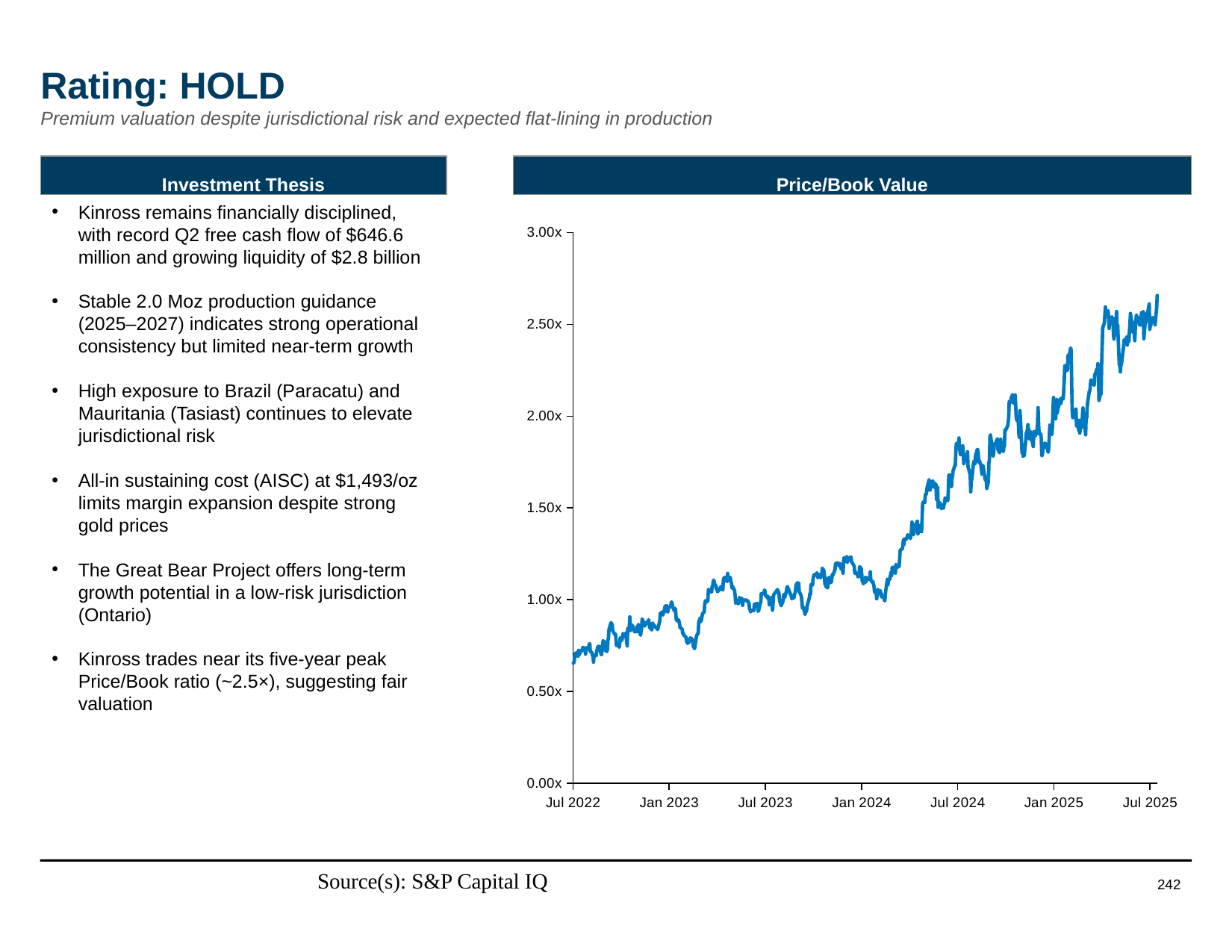
What is the highest value labelled on the y axis of the Price/Book Value chart? 3.00x Is the Price/Book Value at Jul 2024 greater or less than 1.00x? greater What kind of chart is shown under the title Price/Book Value? line chart Is the Price/Book Value at Jan 2024 greater or less than 1.50x? less Which is larger, the Price/Book Value at Jan 2024 or at Jul 2024? Jul 2024 Is the Price/Book Value at Jul 2025 greater or less than 2.00x? greater What is the title of the chart on the right side of the slide? Price/Book Value Does the Price/Book Value line generally rise or fall from Jul 2022 to Jul 2025? rise Which is larger, the Price/Book Value at Jul 2022 or at Jul 2025? Jul 2025 How many date labels are shown on the x axis of the Price/Book Value chart? 7